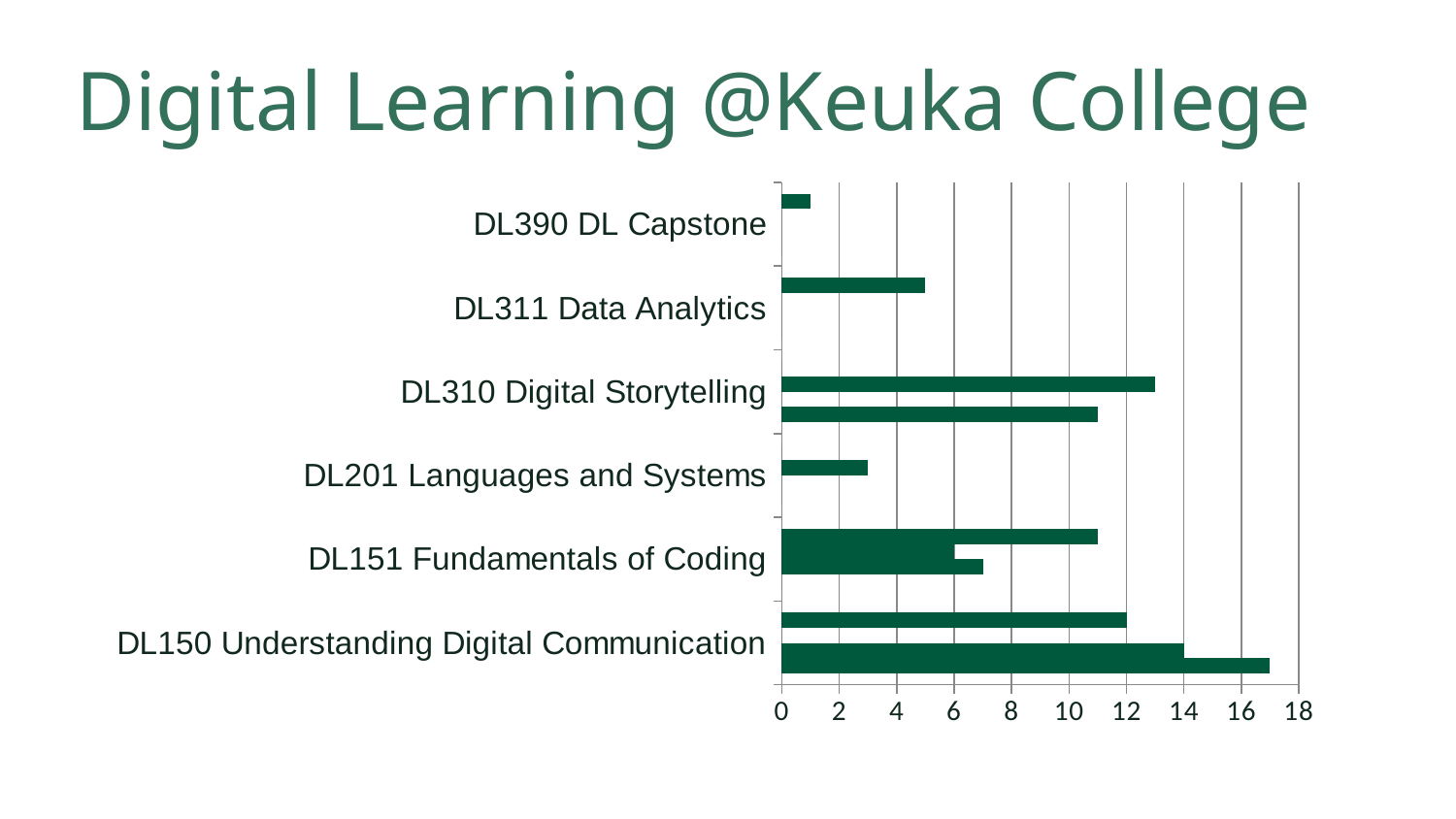
Which course has the longest bar on the chart? DL150 Understanding Digital Communication Which has the larger value, DL311 Data Analytics or DL201 Languages and Systems? DL311 Data Analytics Is the longer bar for DL310 Digital Storytelling greater or less than 12? greater What is the highest value shown on the chart's horizontal axis? 18 Is the value for DL201 Languages and Systems greater or less than 4? less What is the title of the slide containing the chart? Digital Learning @Keuka College How many course categories are listed on the chart's vertical axis? 6 Is the value for DL311 Data Analytics greater or less than 4? greater Which course has the shortest bar on the chart? DL390 DL Capstone What kind of chart is shown on the slide? bar chart